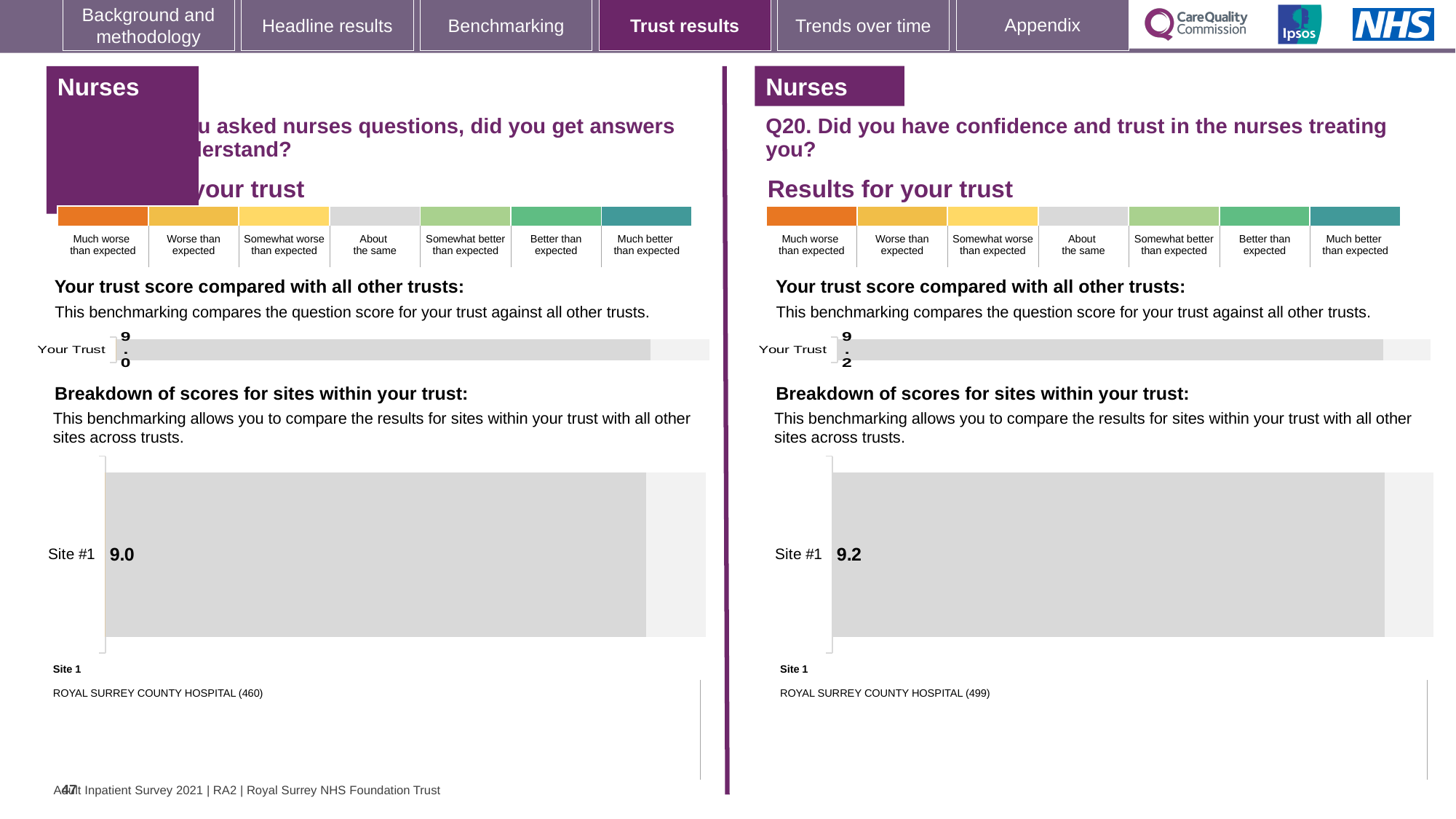
What type of chart is used to show the Site #1 score on the right-hand side of the slide? Bar chart Which site is labelled as Site 1 beneath the left-hand breakdown chart? ROYAL SURREY COUNTY HOSPITAL (460) How many sites are shown in the right-hand 'Breakdown of scores for sites within your trust' chart? 1 Which is larger: the Site #1 score on the left-hand chart or the Site #1 score on the right-hand Q20 chart? The right-hand Q20 chart (9.2) On the left-hand 'Your Trust' chart, what is the score shown for Your Trust? 9.0 On the right-hand 'Your Trust' chart for Q20, what is the score shown for Your Trust? 9.2 On the left-hand 'Breakdown of scores for sites within your trust' chart, what is the score for Site #1? 9.0 How many sites are shown in the left-hand 'Breakdown of scores for sites within your trust' chart? 1 What is the difference between the Site #1 score on the right-hand Q20 chart and the Site #1 score on the left-hand chart? 0.2 On the right-hand 'Breakdown of scores for sites within your trust' chart for Q20, what is the score for Site #1? 9.2 Which site is labelled as Site 1 beneath the right-hand Q20 breakdown chart? ROYAL SURREY COUNTY HOSPITAL (499)